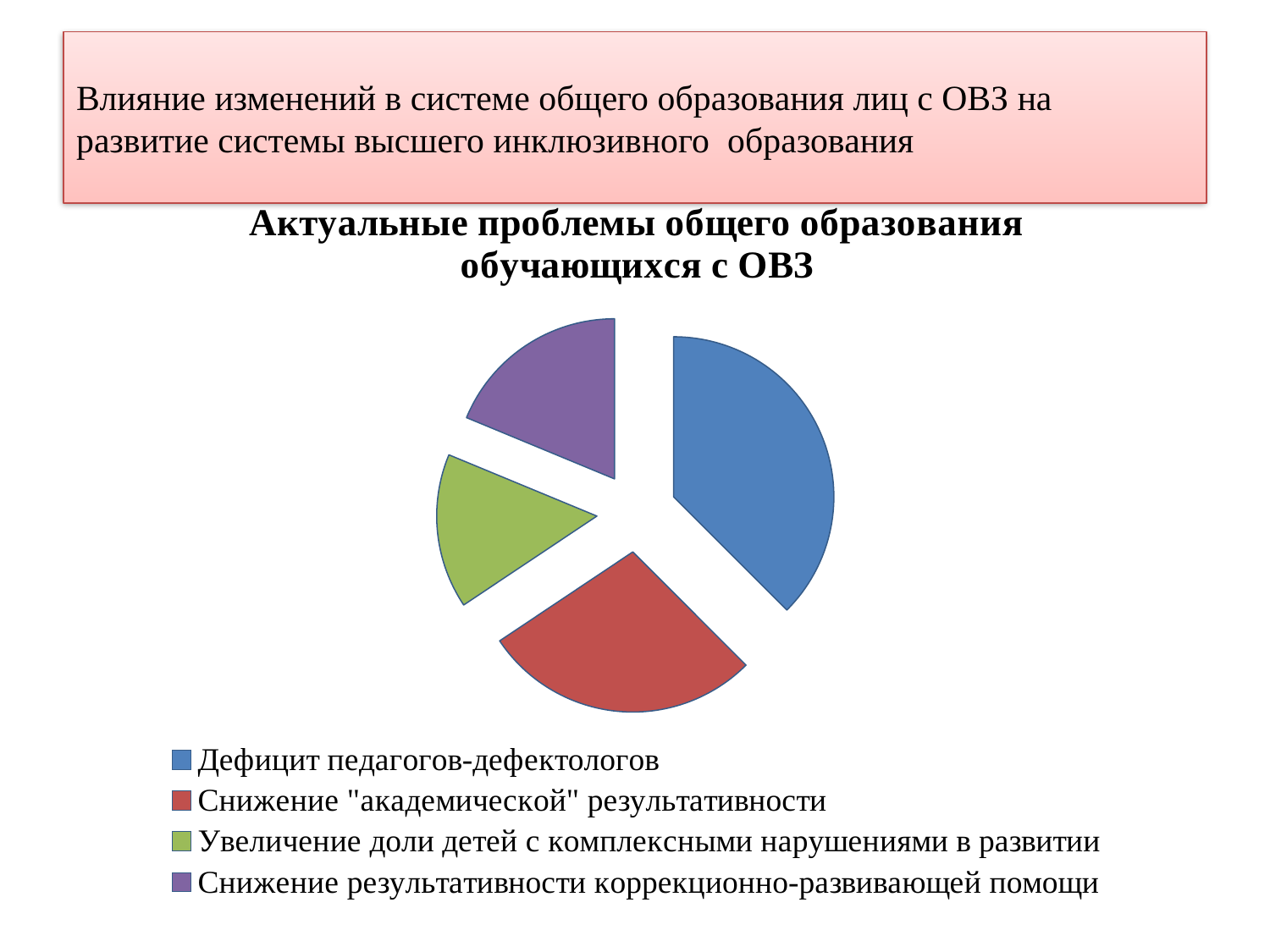
How many entries does the chart legend list? 4 Which slice is larger: "Снижение "академической" результативности" or "Увеличение доли детей с комплексными нарушениями в развитии"? Снижение "академической" результативности What colour is the slice for "Увеличение доли детей с комплексными нарушениями в развитии"? green What kind of chart is shown on the slide? pie chart Which slice is larger: "Снижение результативности коррекционно-развивающей помощи" or "Снижение "академической" результативности"? Снижение "академической" результативности Which category has the smallest slice of the pie chart? Увеличение доли детей с комплексными нарушениями в развитии Which category has the largest slice of the pie chart? Дефицит педагогов-дефектологов Which slice is larger: "Дефицит педагогов-дефектологов" or "Снижение результативности коррекционно-развивающей помощи"? Дефицит педагогов-дефектологов How many slices does the pie chart have? 4 What is the title of the pie chart? Актуальные проблемы общего образования обучающихся с ОВЗ